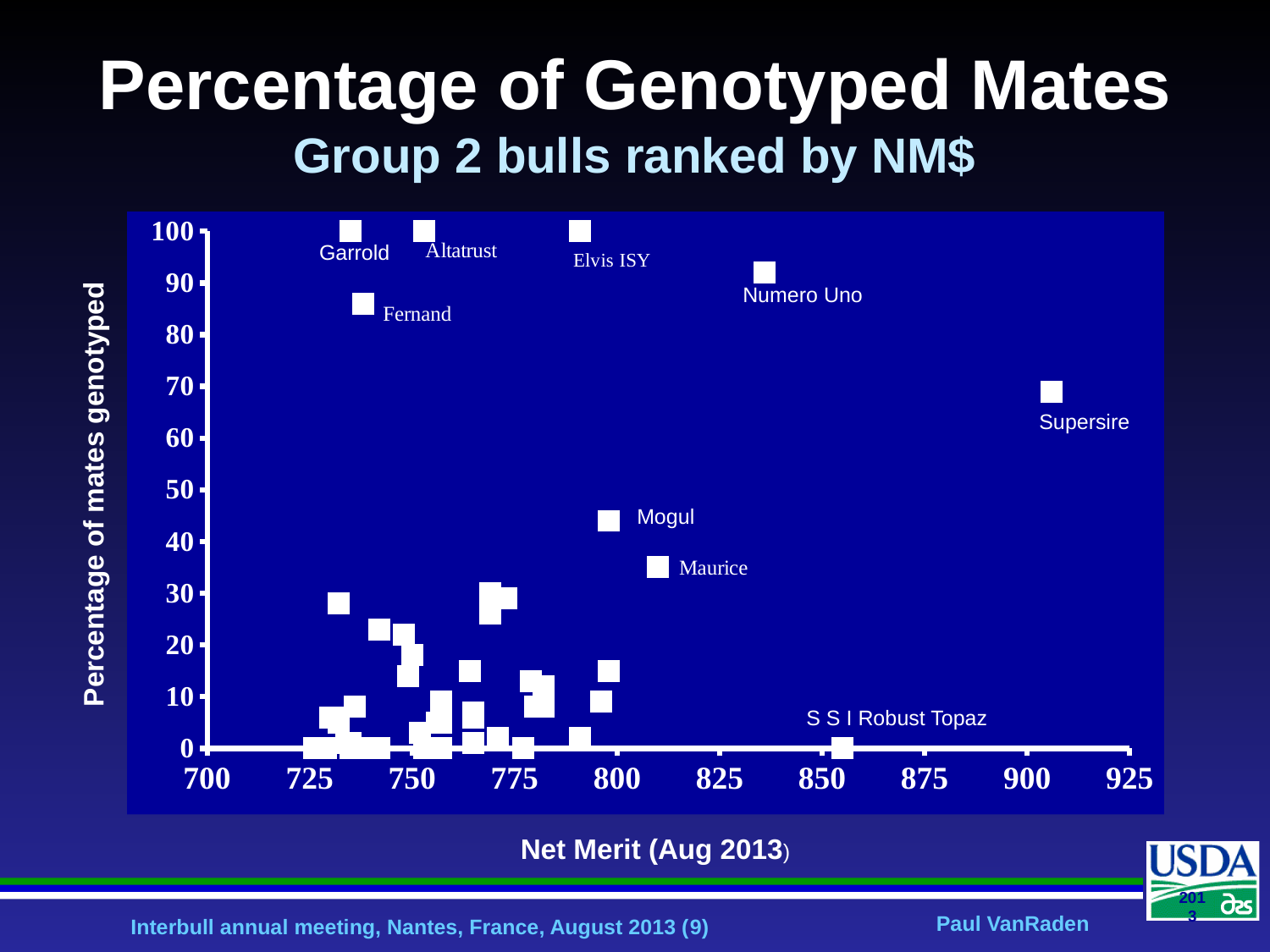
Is the percentage of mates genotyped for Supersire greater or less than 60? greater Is the percentage of mates genotyped for Fernand greater or less than 80? greater Is the percentage of mates genotyped for Numero Uno greater or less than 80? greater Which has a higher Net Merit value, Garrold or Elvis ISY? Elvis ISY Which labeled bull has the lowest percentage of mates genotyped? S S I Robust Topaz Which has a higher percentage of mates genotyped, Mogul or Maurice? Mogul What is the title of the x axis? Net Merit (Aug 2013) Which has a higher percentage of mates genotyped, Fernand or Numero Uno? Numero Uno What kind of chart is shown on the slide? scatter plot Which labeled bull has the highest Net Merit value? Supersire